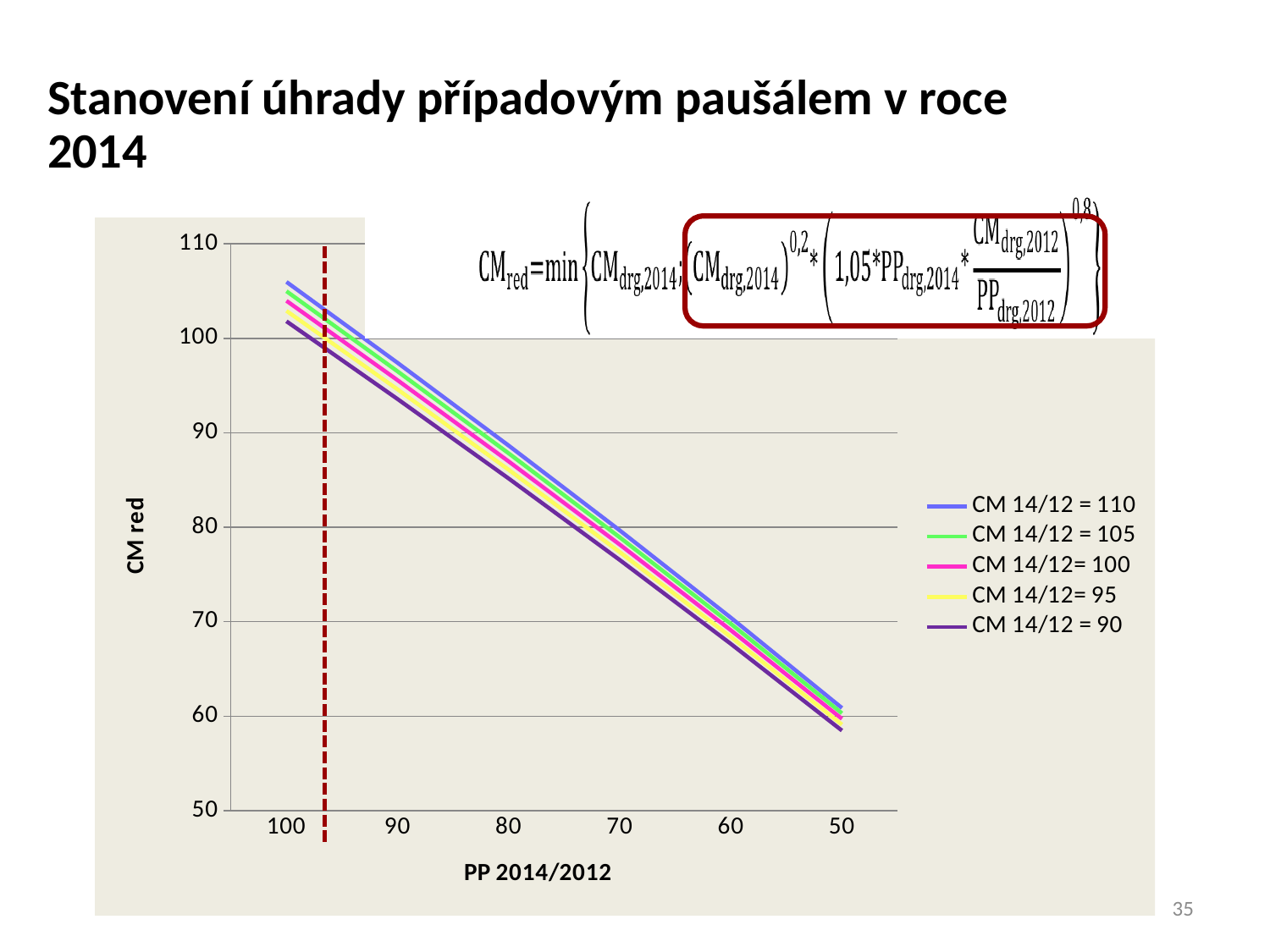
What is the title of the vertical axis? CM red What kind of chart is shown on the slide? line chart Which series has the highest CM red values across the chart? CM 14/12 = 110 Is the value for CM 14/12 = 100 at PP 2014/2012 = 70 greater or less than 90? less Is the value for CM 14/12 = 110 at PP 2014/2012 = 100 greater or less than 100? greater Which series has the lowest CM red values across the chart? CM 14/12 = 90 Do the CM red values rise or fall as PP 2014/2012 goes from 100 to 50 along the x axis? fall At PP 2014/2012 = 100, which is larger: the value for CM 14/12 = 110 or for CM 14/12 = 90? CM 14/12 = 110 How many series does the legend list? 5 What is the title of the horizontal axis? PP 2014/2012 How many tick values are labelled on the PP 2014/2012 axis? 6 Is the value for CM 14/12 = 90 at PP 2014/2012 = 50 greater or less than 70? less